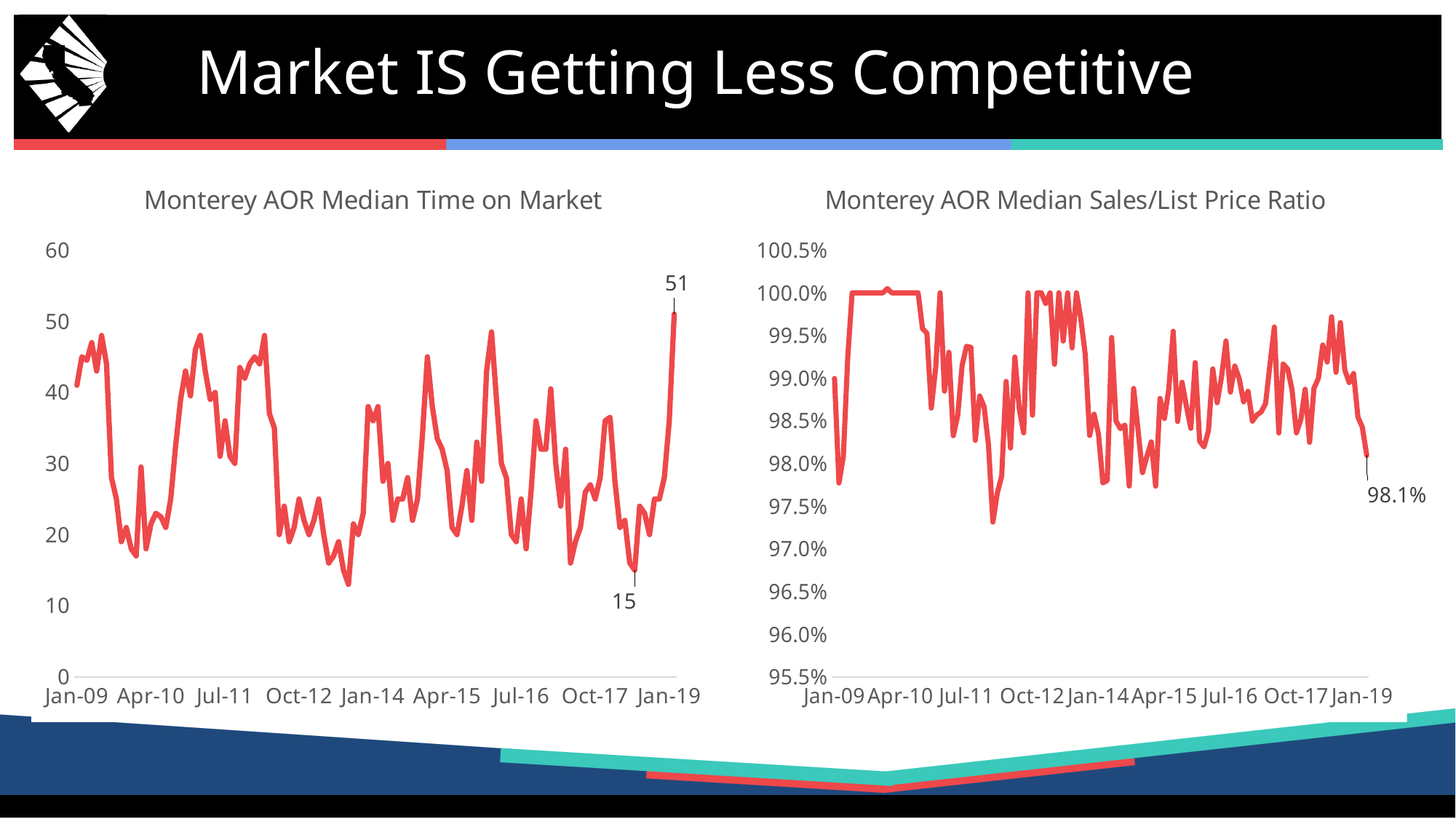
What kind of chart is the Monterey AOR Median Time on Market chart? line chart On the Monterey AOR Median Time on Market chart, what is the difference between the two labeled values, 51 and 15? 36 On the Monterey AOR Median Time on Market chart, what is the value of the lower data label shown near the end of the series? 15 On the Monterey AOR Median Time on Market chart, is the value at Jan-09 greater or less than 30? greater How many charts are shown on the slide? 2 On the Monterey AOR Median Sales/List Price Ratio chart, what is the value of the data label at the end of the line? 98.1% What is the title of the chart on the right side of the slide? Monterey AOR Median Sales/List Price Ratio On the Monterey AOR Median Sales/List Price Ratio chart, is the value around Apr-10 greater or less than 99.5%? greater On the Monterey AOR Median Time on Market chart, is the lowest point near Jan-14 greater or less than 20? less On the Monterey AOR Median Time on Market chart, what is the value of the data label at the end of the line (Jan-19)? 51 On the Monterey AOR Median Time on Market chart, does the line rise or fall from the labeled low of 15 to the end at Jan-19? rise